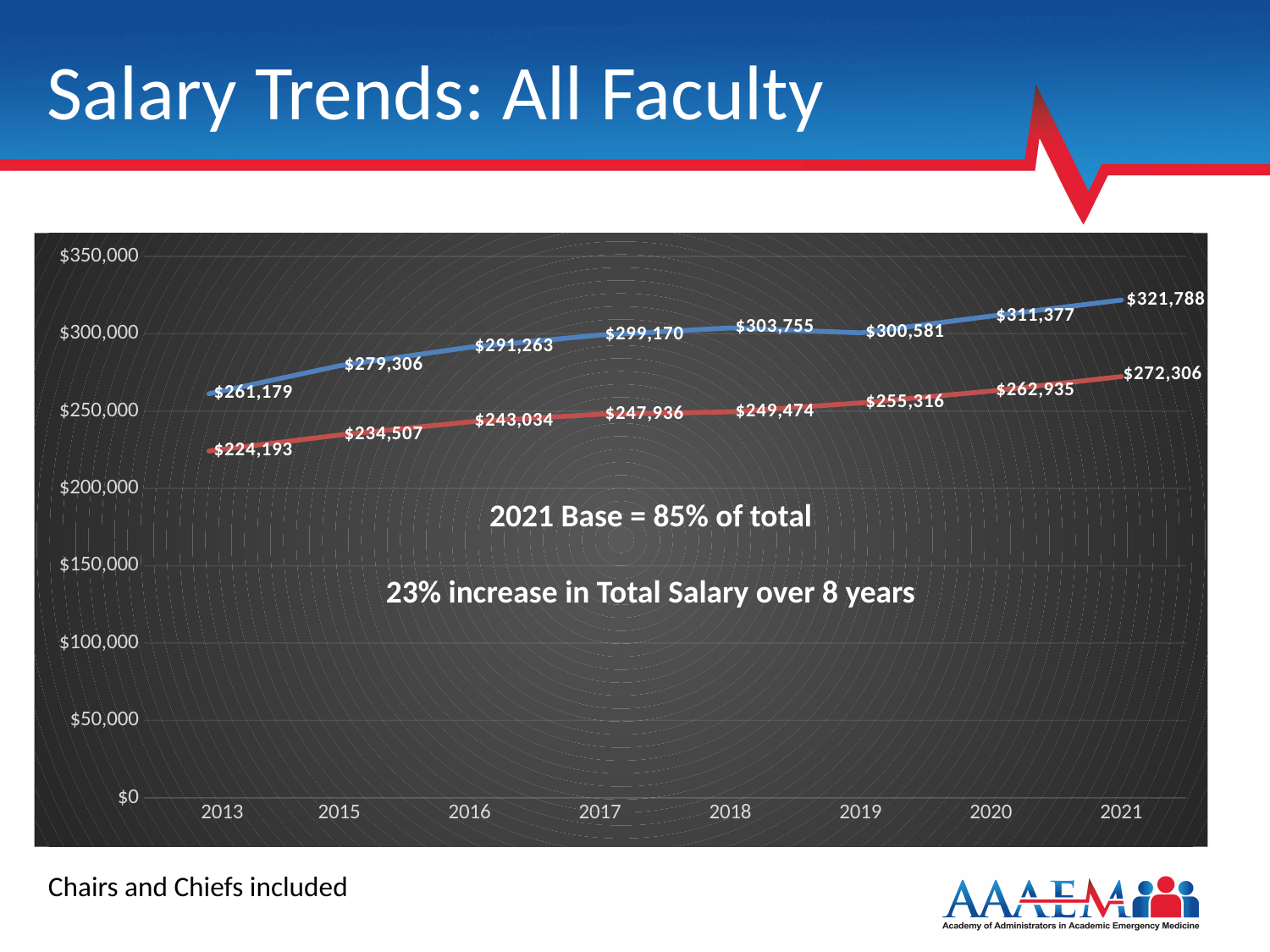
Which is larger for the blue line: the 2018 value or the 2019 value? 2018 In which year does the blue line reach its highest value? 2021 Overall, do the values of the red line rise or fall from 2013 to 2021? Rise How many years are plotted on the x axis? 8 What is the value of the red line in 2013? $224,193 In which year is the red line at its lowest value? 2013 What type of chart is shown on the slide? Line chart What is the difference between the blue line and the red line in 2021? $49,482 What is the value of the red line in 2019? $255,316 By how much did the blue line increase from 2013 to 2021? $60,609 What is the value of the blue line in 2021? $321,788 What is the value of the blue line in 2018? $303,755